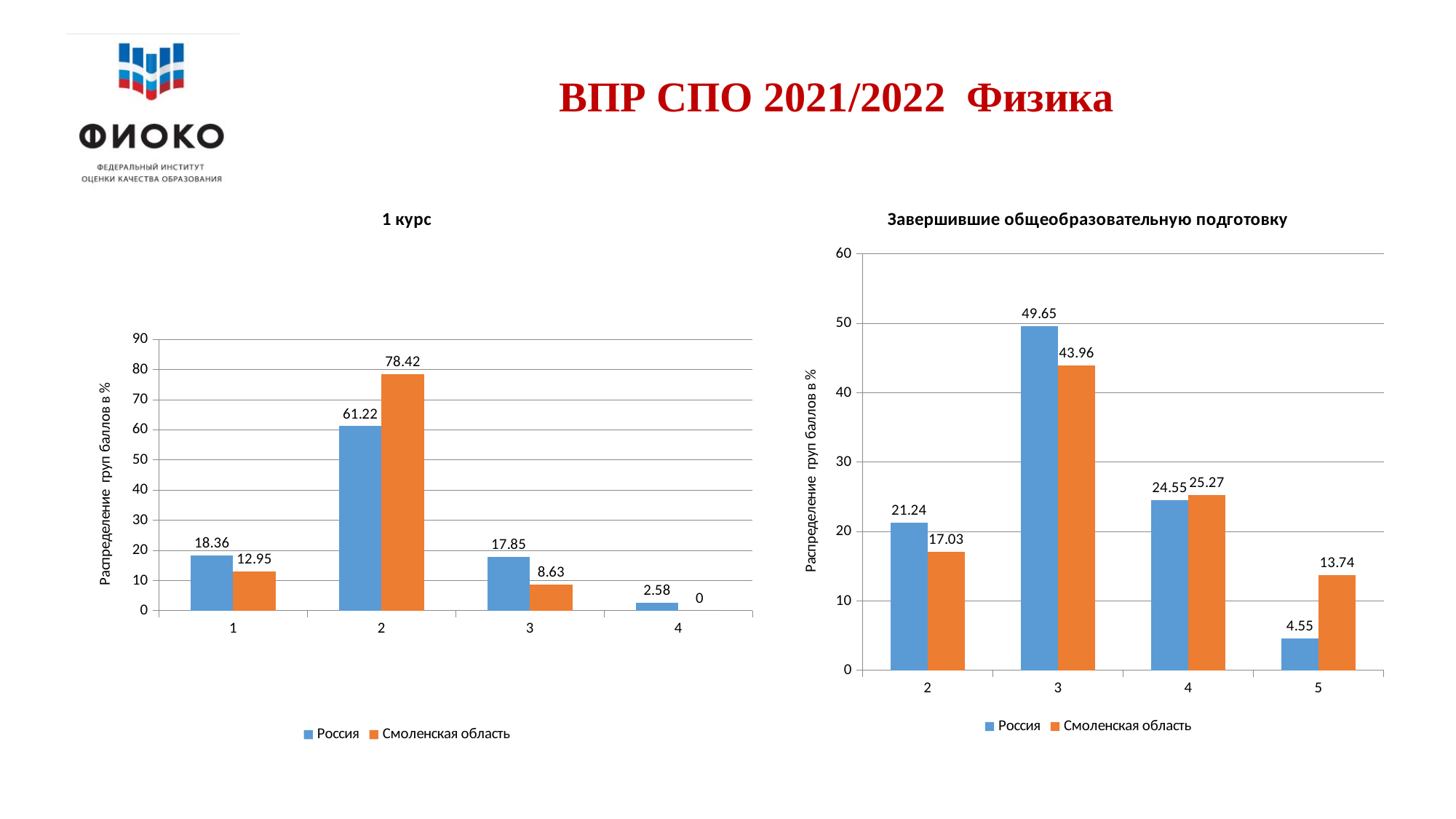
In the chart titled "1 курс", which category has the highest value for Россия? 2 In the chart titled "1 курс", what is the difference between the Смоленская область and Россия values in category 2? 17.20 In the chart titled "Завершившие общеобразовательную подготовку", what is the value for Россия in category 3? 49.65 What type of chart is the chart titled "1 курс"? Bar chart In the chart titled "1 курс", how many categories are shown on the x axis? 4 In the chart titled "Завершившие общеобразовательную подготовку", which is larger in category 5: Россия or Смоленская область? Смоленская область In the chart titled "1 курс", what is the value for Смоленская область in category 2? 78.42 In the chart titled "Завершившие общеобразовательную подготовку", what is the difference between Россия and Смоленская область in category 2? 4.21 In the chart titled "1 курс", what is the value for Смоленская область in category 4? 0 In the chart titled "1 курс", what is the value for Россия in category 4? 2.58 In the chart titled "Завершившие общеобразовательную подготовку", which category has the lowest value for Россия? 5 How many series does the legend of the chart titled "Завершившие общеобразовательную подготовку" list? 2